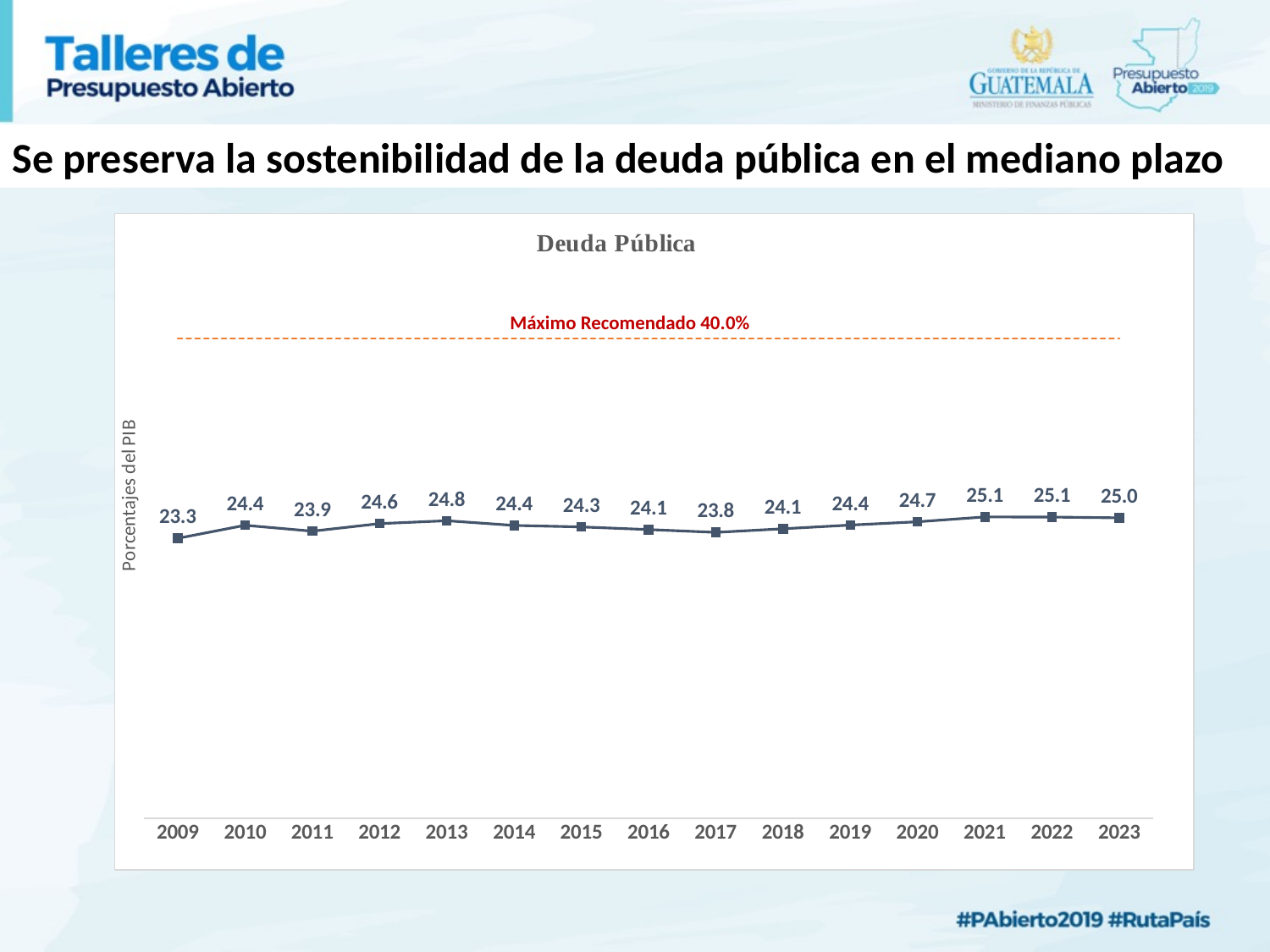
What is the label of the y axis? Porcentajes del PIB Is the value for 2021 greater or less than the 40.0% maximum recommended line? less What kind of chart is this? line chart What is the value for 2013? 24.8 What is the value for 2023? 25.0 Which is larger, the value for 2013 or the value for 2017? 2013 What is the value for 2009? 23.3 Do the values generally rise or fall from 2017 to 2021? rise What is the title of the chart? Deuda Pública How many years are shown on the x axis? 15 Which year has the lowest value? 2009 What is the difference between the values for 2023 and 2009? 1.7